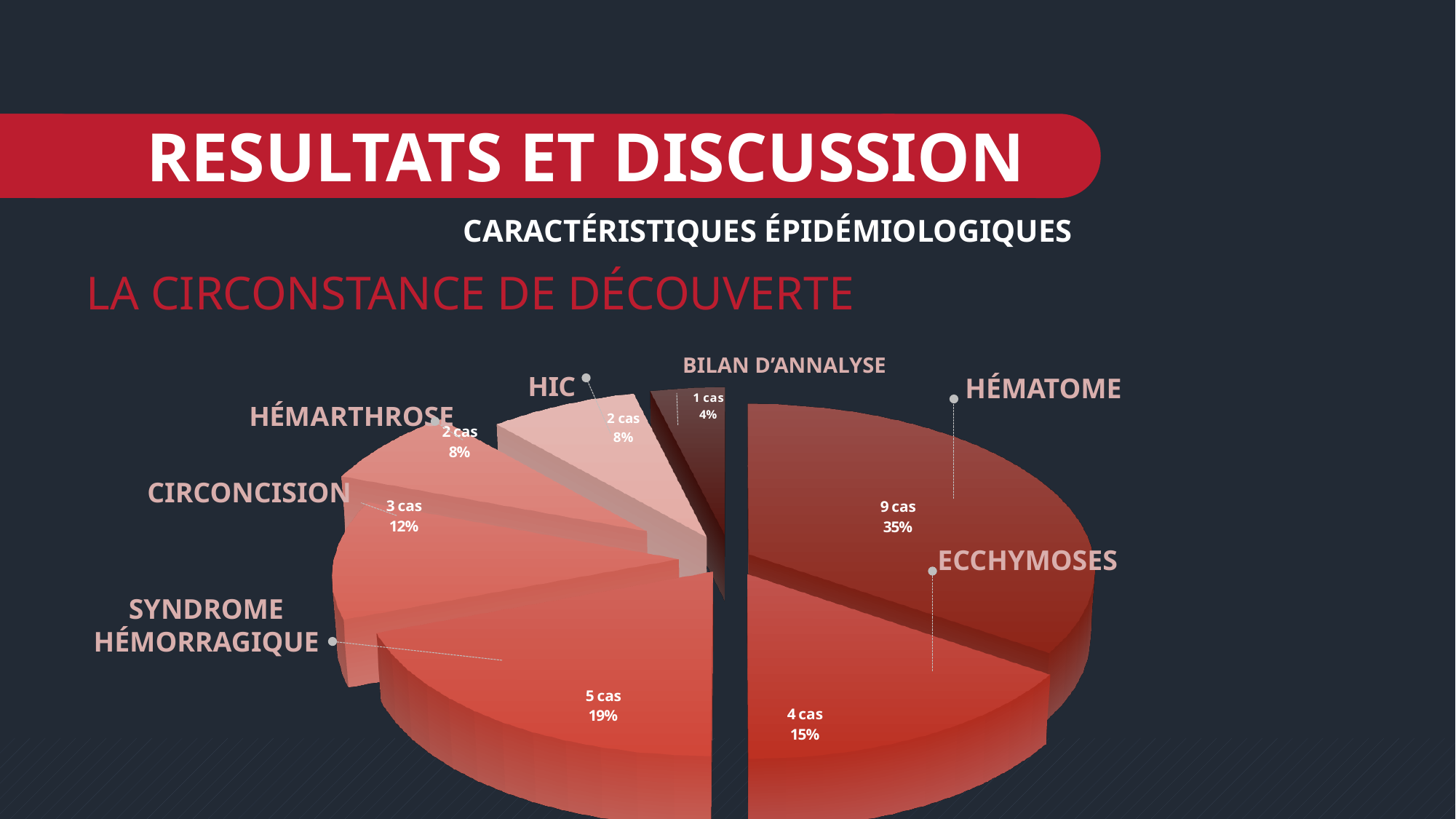
What percentage is shown for CIRCONCISION? 12% Which category has the smallest slice of the pie? BILAN D'ANNALYSE What is the title of the chart section on the slide? LA CIRCONSTANCE DE DÉCOUVERTE How many cases are shown for SYNDROME HÉMORRAGIQUE? 5 cas What percentage of the pie does ECCHYMOSES represent? 15% How many categories are shown in the pie chart? 7 What is the total number of cases across all slices of the pie? 26 cas What is the difference in number of cases between HÉMATOME and ECCHYMOSES? 5 cas How many cases are shown for HÉMATOME? 9 cas Which category has the largest slice of the pie? HÉMATOME What type of chart is shown on the slide? Pie chart Which has more cases, SYNDROME HÉMORRAGIQUE or CIRCONCISION? SYNDROME HÉMORRAGIQUE